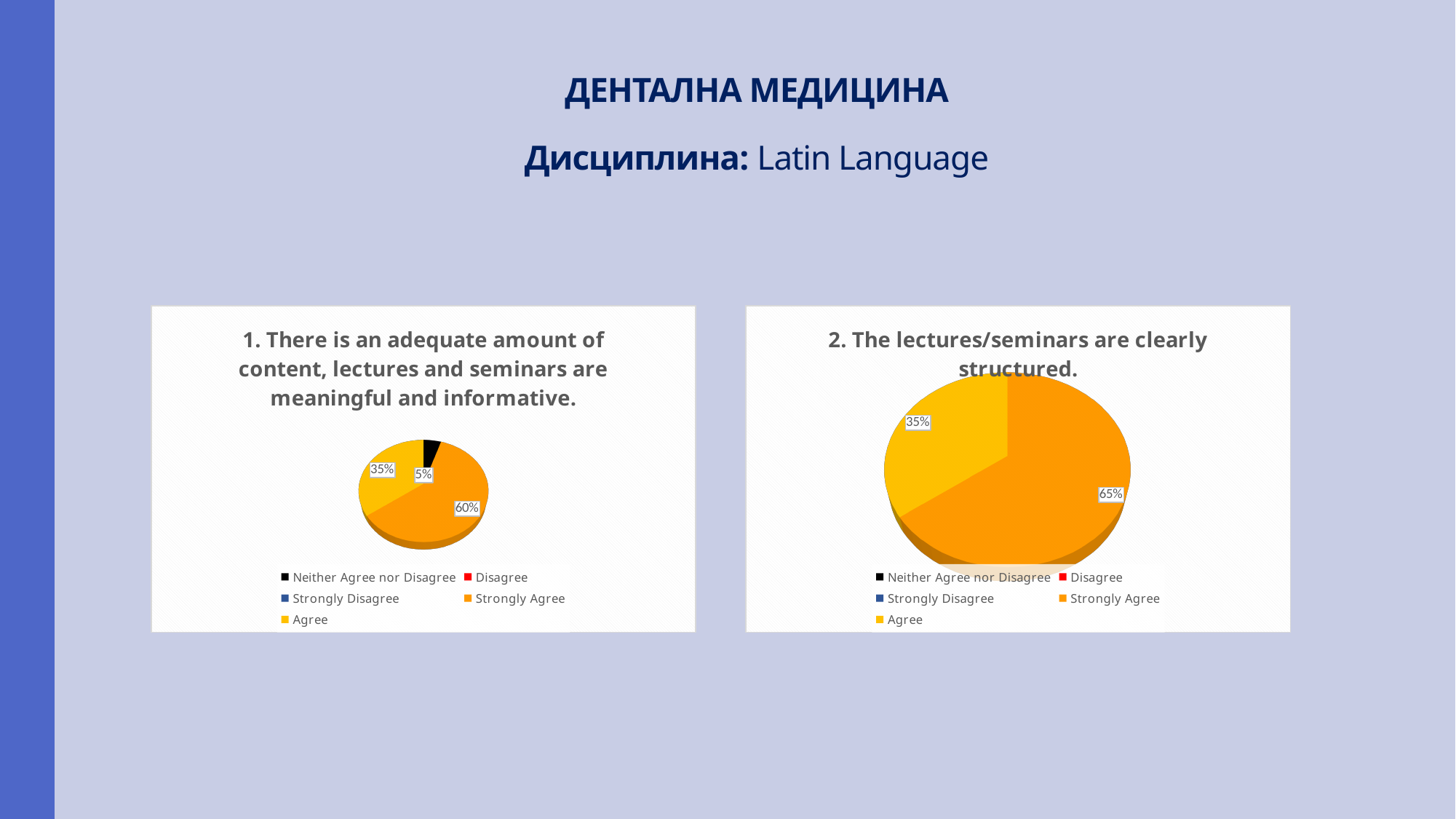
In the left chart (question 1), which is larger: the Agree slice or the Strongly Agree slice? Strongly Agree In the left chart (question 1), what share of responses is Agree? 35% How many entries does the legend of the right chart (question 2) list? 5 In the right chart (question 2), what share of responses is Agree? 35% What is the title of the right chart? 2. The lectures/seminars are clearly structured. What type of chart is used on this slide? Pie chart In the left chart (question 1), what share of responses is Strongly Agree? 60% In the left chart (question 1), what share of responses is Neither Agree nor Disagree? 5% In the right chart (question 2), what is the difference between the Strongly Agree and Agree shares? 30% In the left chart (question 1), which response category has the smallest visible slice? Neither Agree nor Disagree In the right chart (question 2), what share of responses is Strongly Agree? 65% In the left chart (question 1), which response category has the largest slice? Strongly Agree